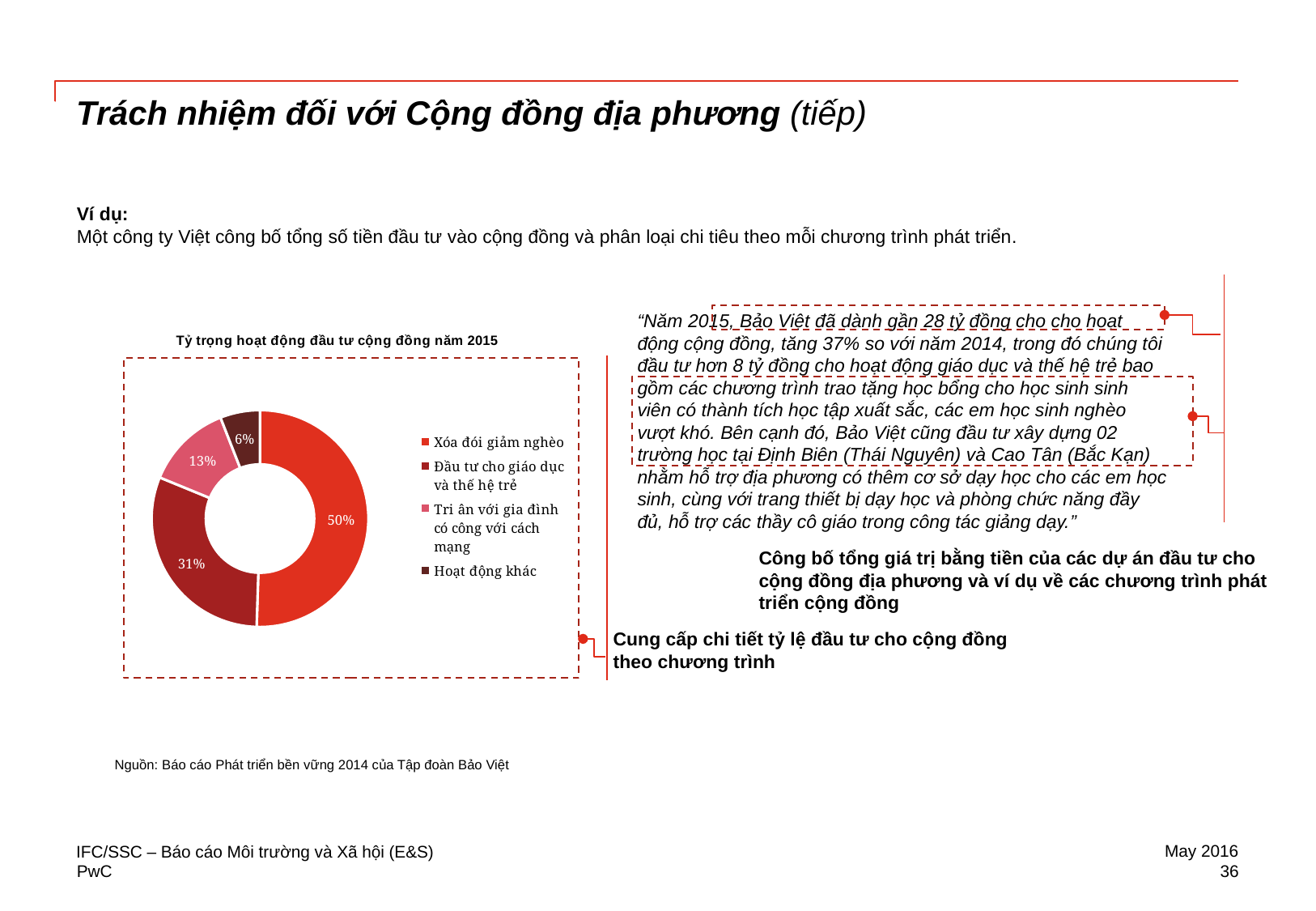
What is the title of the chart? Tỷ trọng hoạt động đầu tư cộng đồng năm 2015 What share of the chart does "Đầu tư cho giáo dục và thế hệ trẻ" represent? 31% What is the difference in percentage points between "Xóa đói giảm nghèo" and "Đầu tư cho giáo dục và thế hệ trẻ"? 19 percentage points Which is larger: the share for "Tri ân với gia đình có công với cách mạng" or the share for "Hoạt động khác"? Tri ân với gia đình có công với cách mạng What share of the chart does "Tri ân với gia đình có công với cách mạng" represent? 13% Which category has the smallest share in the chart? Hoạt động khác What share of the chart does "Xóa đói giảm nghèo" represent? 50% What is the combined share of "Tri ân với gia đình có công với cách mạng" and "Hoạt động khác"? 19% What share of the chart does "Hoạt động khác" represent? 6% Which category has the largest share in the chart? Xóa đói giảm nghèo What type of chart is shown on the slide? Doughnut (pie) chart How many categories does the legend of the chart list? 4